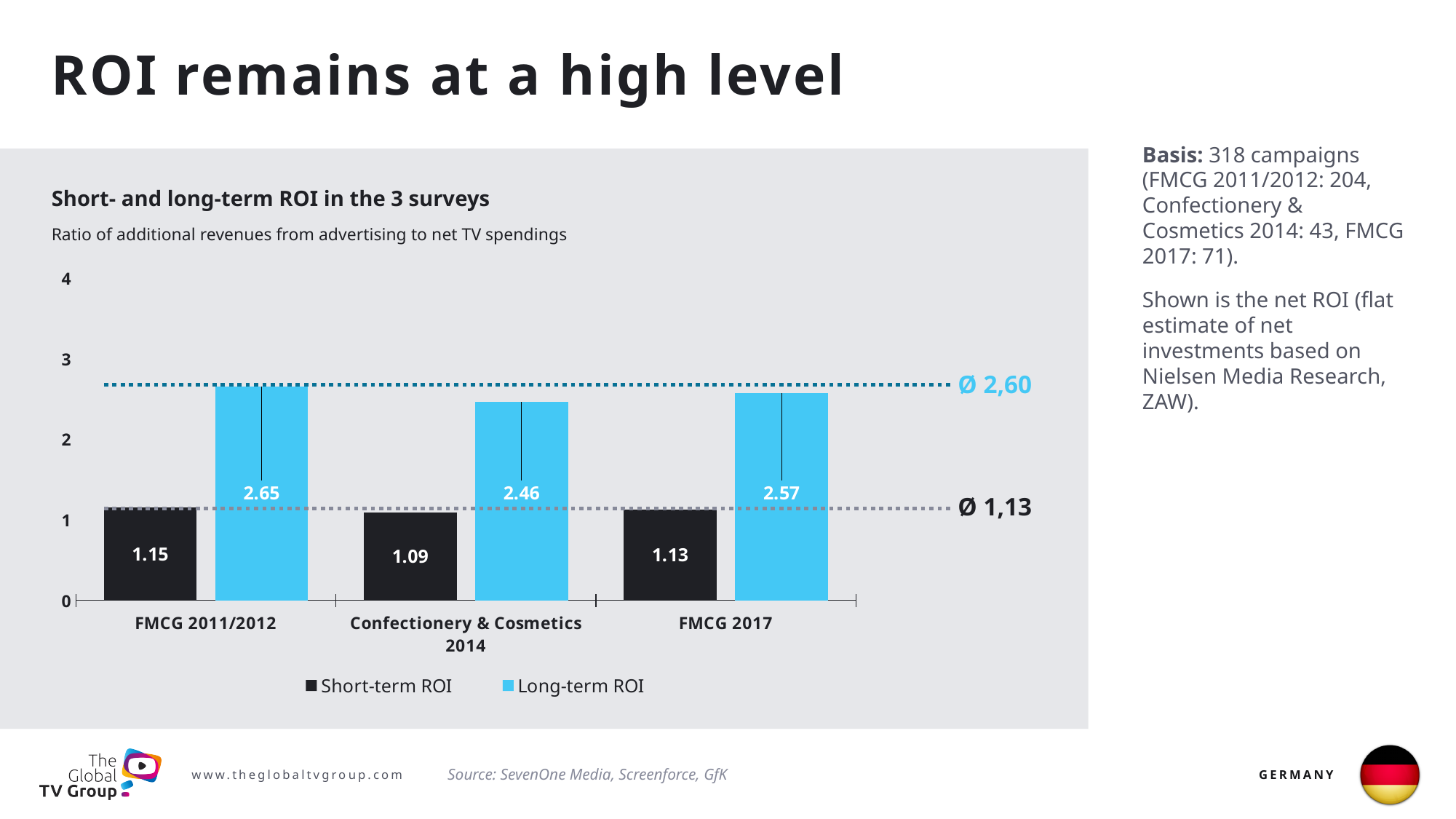
What kind of chart is shown on the slide? bar chart What is the Short-term ROI for FMCG 2011/2012? 1.15 What average value is marked by the upper dotted line on the chart? Ø 2,60 How many surveys (categories) are shown on the x axis? 3 What is the Long-term ROI for FMCG 2017? 2.57 Which survey has the lowest Short-term ROI? Confectionery & Cosmetics 2014 Is the Long-term ROI for Confectionery & Cosmetics 2014 greater or less than 3? less How many series does the legend list? 2 What is the Long-term ROI for Confectionery & Cosmetics 2014? 2.46 What is the difference between the Long-term ROI and the Short-term ROI for FMCG 2017? 1.44 Is the Long-term ROI for FMCG 2011/2012 larger or smaller than the Long-term ROI for Confectionery & Cosmetics 2014? larger Which survey has the highest Long-term ROI? FMCG 2011/2012